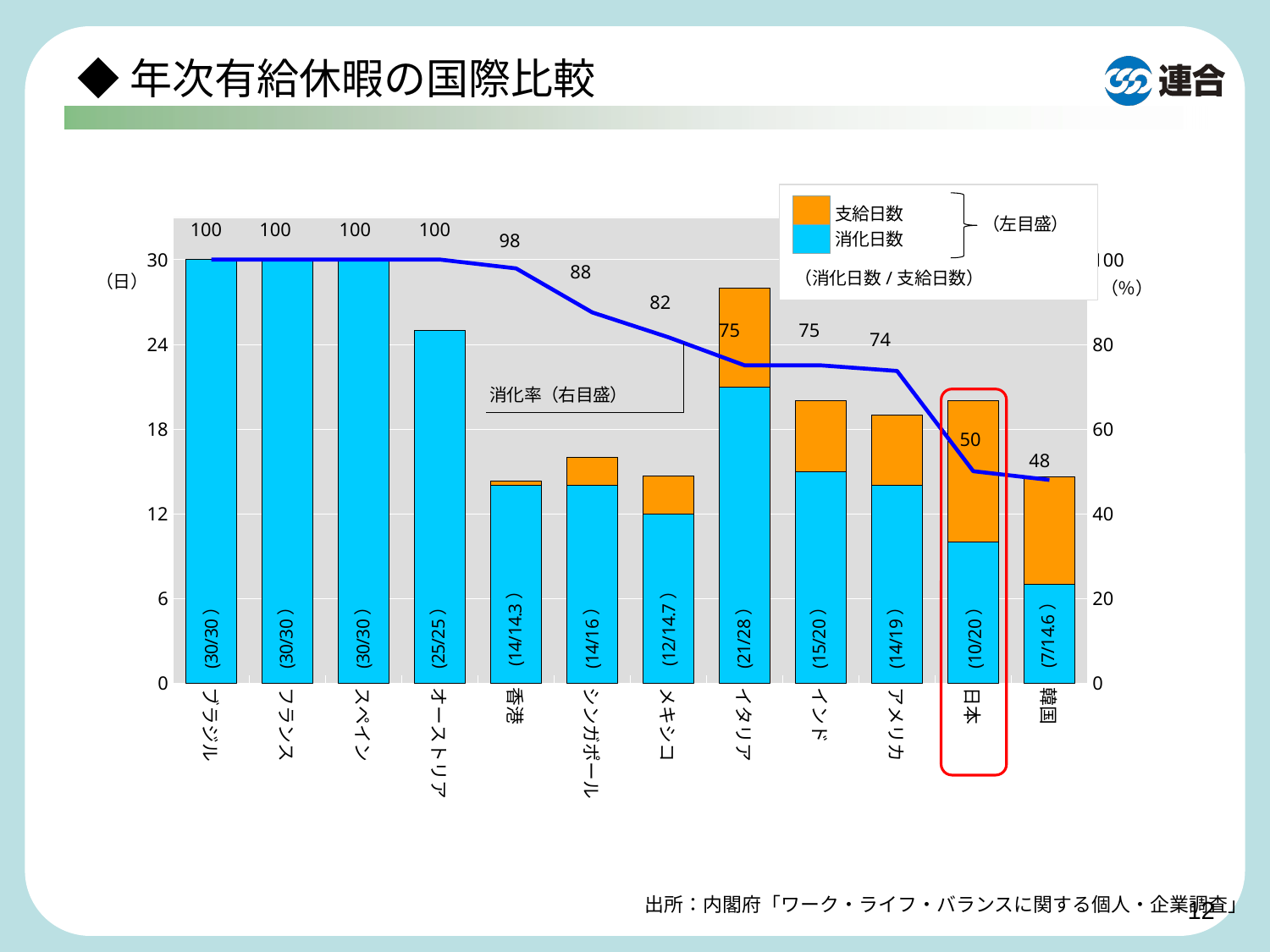
What is the (消化日数 / 支給日数) label printed inside the bar for 日本? (10/20) Which has the higher 消化率, メキシコ or シンガポール? シンガポール Which country's bar is highlighted with a red box? 日本 What is the 消化率 (%) value shown for 日本? 50 What is the 消化率 (%) value shown for 韓国? 48 Does the 消化率 line rise or fall moving from left to right across the countries? fall According to the bar label, what is the 消化日数 for イタリア? 21 Which country has the lowest 消化率 on the line? 韓国 How many series does the legend box list with coloured squares? 2 What is the difference between the 消化率 values of イタリア and 日本? 25 What kind of chart is shown on the slide? bar chart with a line How many countries are shown on the x axis of the chart? 12